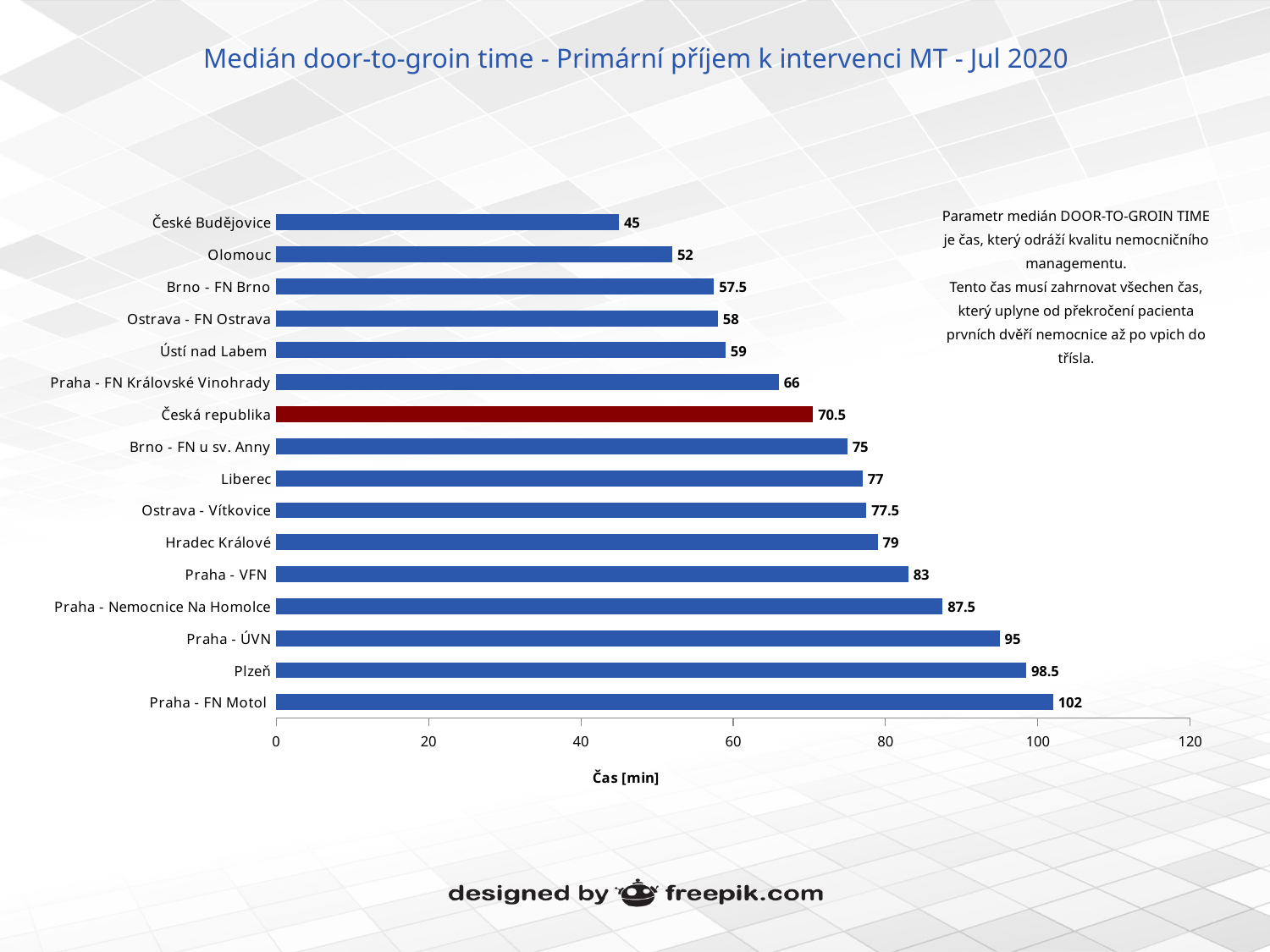
Which category has the lowest value? České Budějovice What is the value shown for Ostrava - Vítkovice? 77.5 What is the label of the horizontal axis? Čas [min] What is the value shown for Česká republika? 70.5 Which category's bar is coloured dark red instead of blue? Česká republika Is the value for Praha - Nemocnice Na Homolce greater or less than 80? greater What kind of chart is shown on the slide? bar chart What is the median door-to-groin time for Praha - FN Motol? 102 Which has a larger value, Liberec or Olomouc? Liberec Which category has the highest value? Praha - FN Motol How many categories are shown in the chart? 16 What is the difference between the values for Plzeň and Praha - ÚVN? 3.5